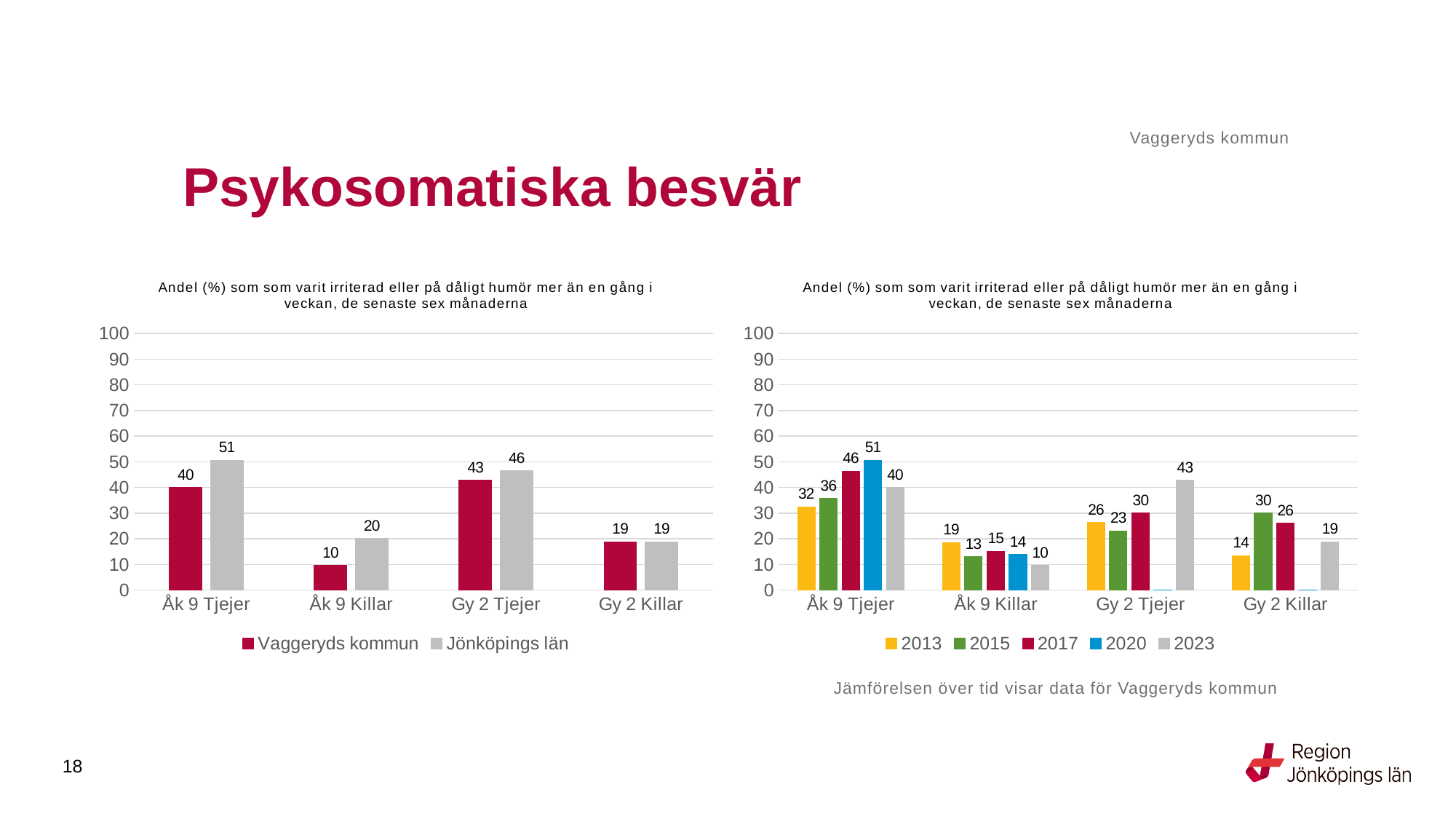
In the right chart, how many series does the legend list? 5 What kind of chart is the right chart? Bar chart In the right chart, what is the value for 2023 for Gy 2 Tjejer? 43 In the left chart, which category has the highest value for Jönköpings län? Åk 9 Tjejer In the left chart, what is the value for Vaggeryds kommun for Åk 9 Tjejer? 40 In the left chart, how many series does the legend list? 2 In the left chart, what is the value for Jönköpings län for Åk 9 Killar? 20 In the right chart, what is the value for 2020 for Åk 9 Tjejer? 51 In the left chart, what is the difference between Jönköpings län and Vaggeryds kommun for Gy 2 Tjejer? 3 In the right chart, what is the difference between 2017 and 2013 for Åk 9 Tjejer? 14 In the left chart, which category has the lowest value for Vaggeryds kommun? Åk 9 Killar In the right chart, which is larger for Gy 2 Killar: 2015 or 2023? 2015